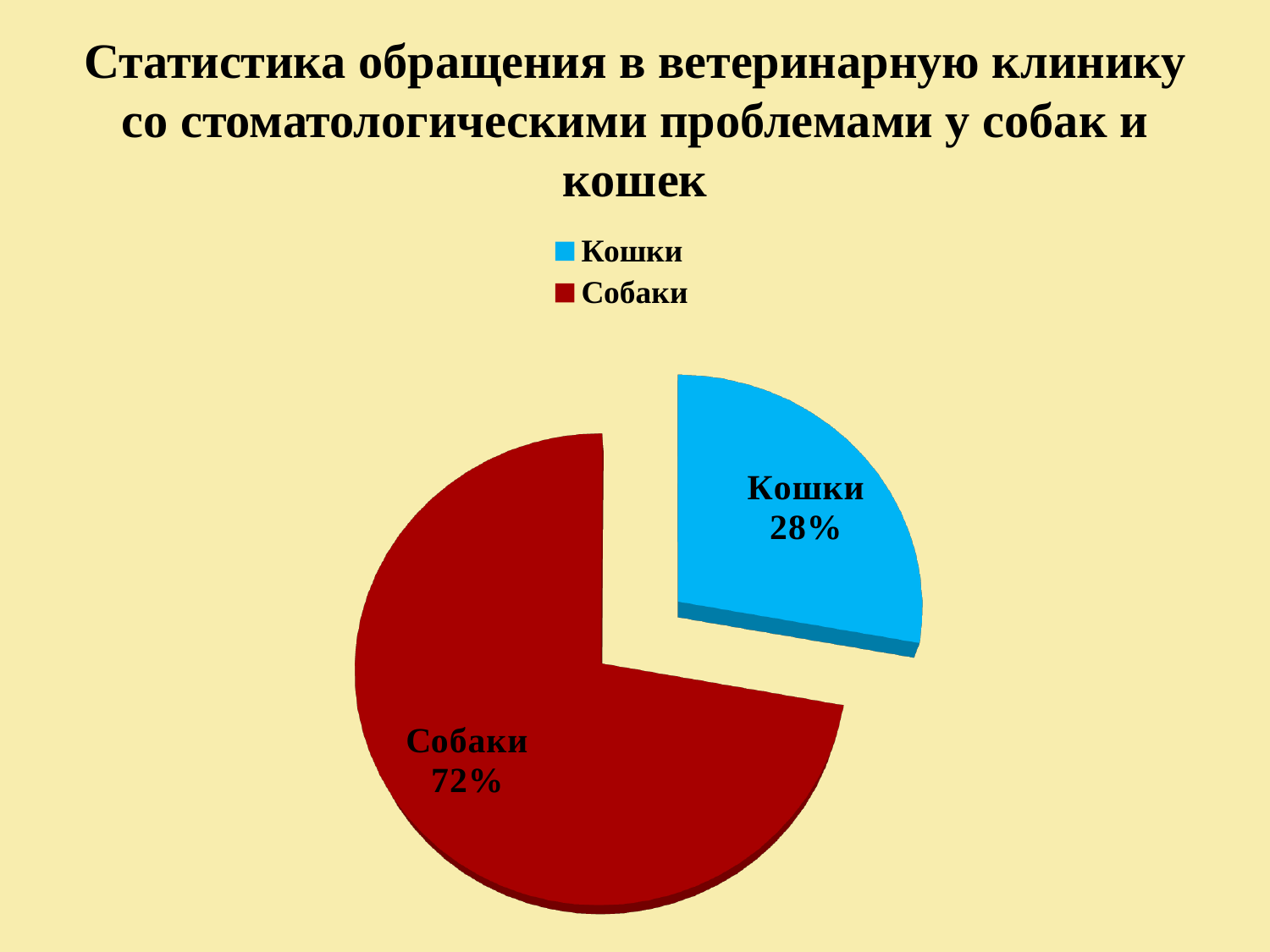
Which slice is larger, Кошки or Собаки? Собаки What share of the pie does Кошки represent? 28% What kind of chart is shown on the slide? Pie chart Is the share for Собаки greater or less than 50%? greater What share of the pie does Собаки represent? 72% Which category has the smallest slice of the pie? Кошки What is the difference in percentage points between the Собаки and Кошки slices? 44 What colour is the Собаки slice? Red How many entries does the legend list? 2 Which category has the largest slice of the pie? Собаки How many slices does the pie chart have? 2 What colour is the Кошки slice? Blue